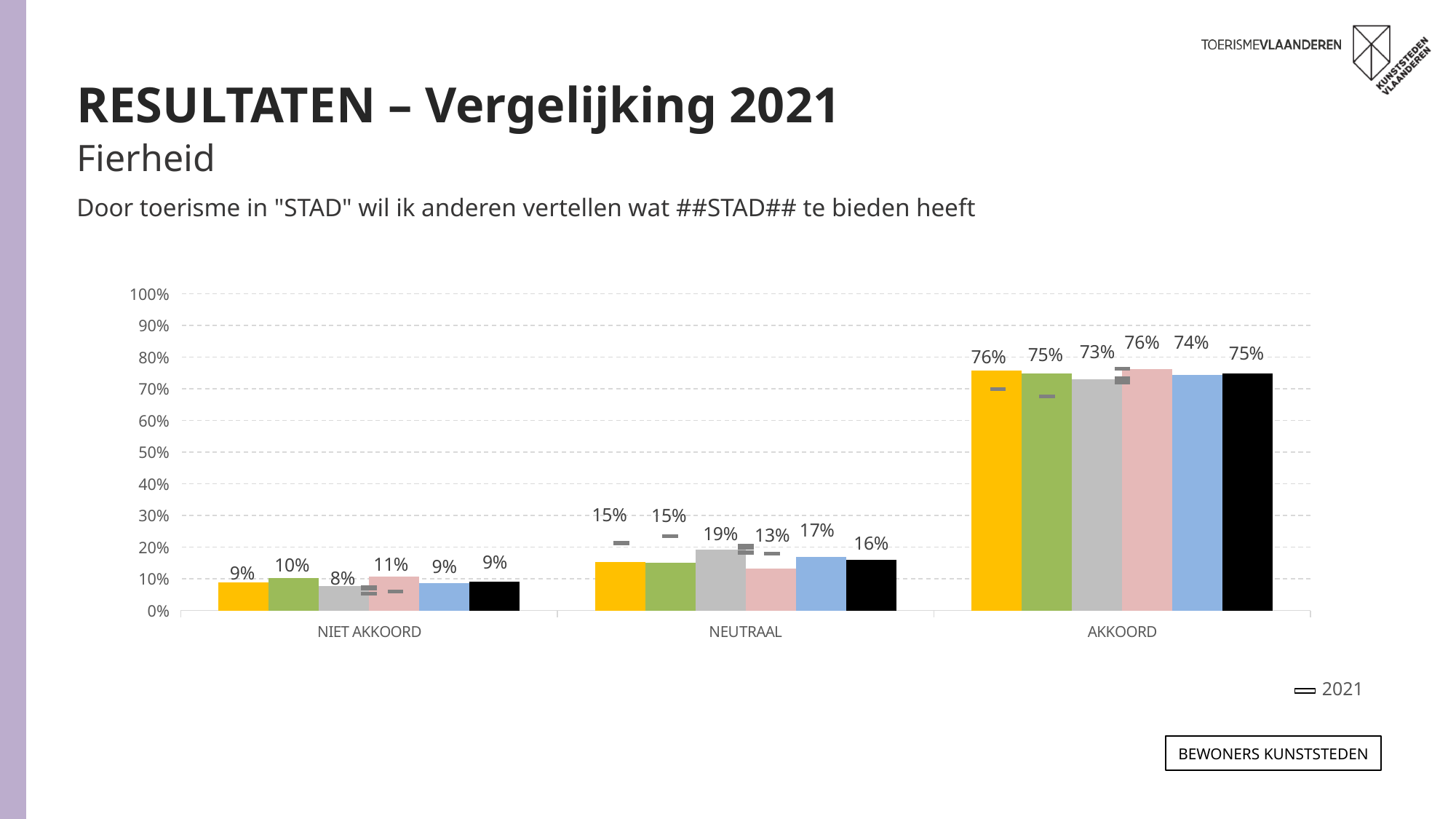
What is the difference between the grey bar and the pink bar in the NEUTRAAL category? 6 percentage points What is the value of the grey bar for NEUTRAAL? 19% Is the value of the grey bar for AKKOORD greater or less than 70%? greater What entry does the chart legend list? 2021 Which is larger: the blue bar for NEUTRAAL or the green bar for NEUTRAAL? the blue bar (17%) Which coloured bar has the highest value in the NEUTRAAL category? grey (19%) Which coloured bar has the lowest value in the AKKOORD category? grey (73%) What is the value of the yellow bar for AKKOORD? 76% What is the value of the pink bar for NIET AKKOORD? 11% What kind of chart is shown on the slide? bar chart What is the value of the black bar for NEUTRAAL? 16% How many categories are shown on the x axis? 3